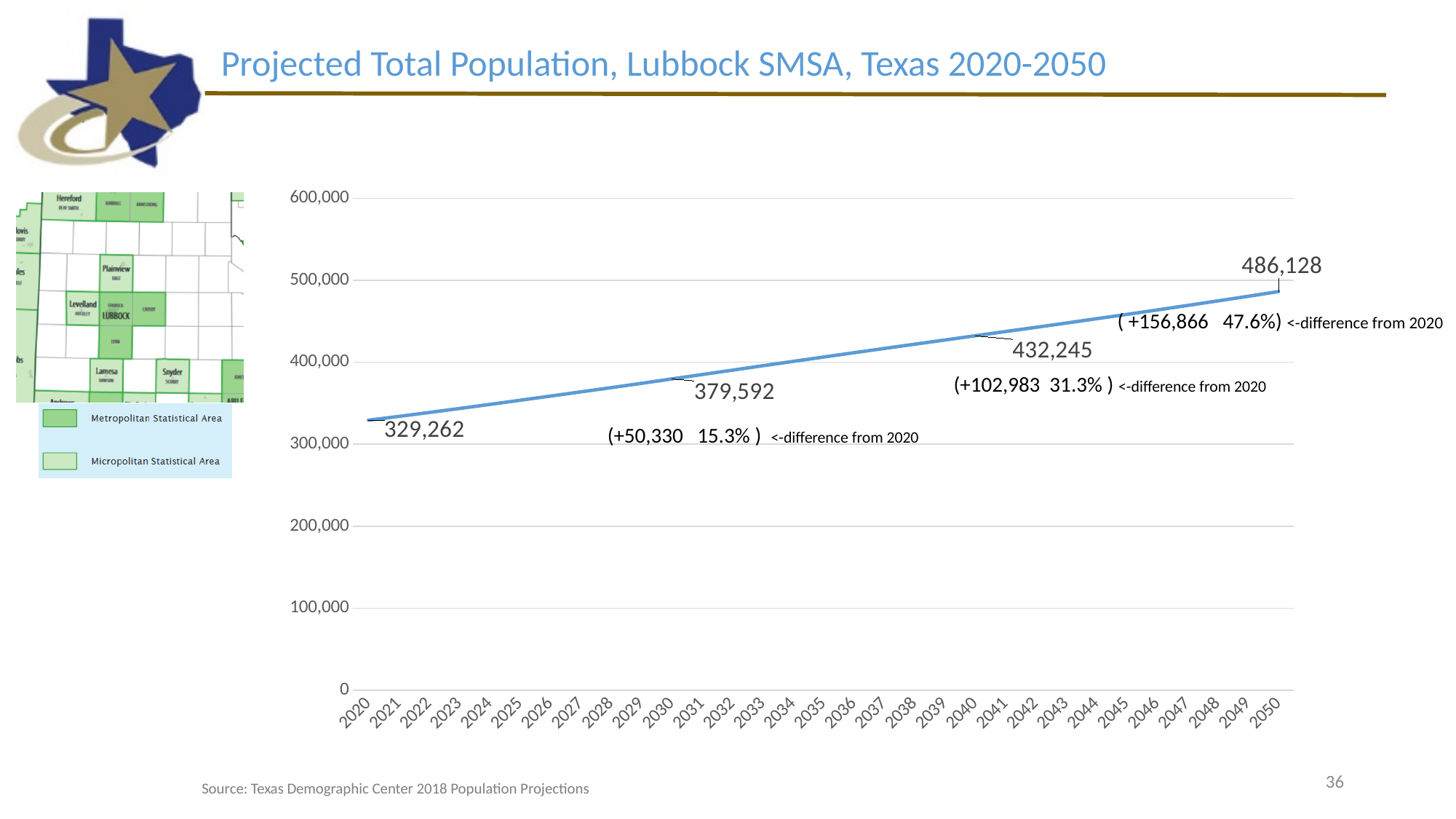
What is the projected total population of the Lubbock SMSA in 2020? 329,262 What is the difference between the projected population in 2050 and in 2020? 156,866 What percentage increase from 2020 is shown for the 2040 projection? 31.3% Which labelled year has the lowest projected population? 2020 Which labelled year has the highest projected population? 2050 What is the difference between the projected population in 2040 and in 2030? 52,653 What is the projected total population of the Lubbock SMSA in 2040? 432,245 What kind of chart is used to show the projected population? line chart What is the projected total population of the Lubbock SMSA in 2030? 379,592 What is the projected total population of the Lubbock SMSA in 2050? 486,128 Is the projected population in 2050 greater or less than 500,000? less Does the projected population rise or fall from 2020 to 2050? rise